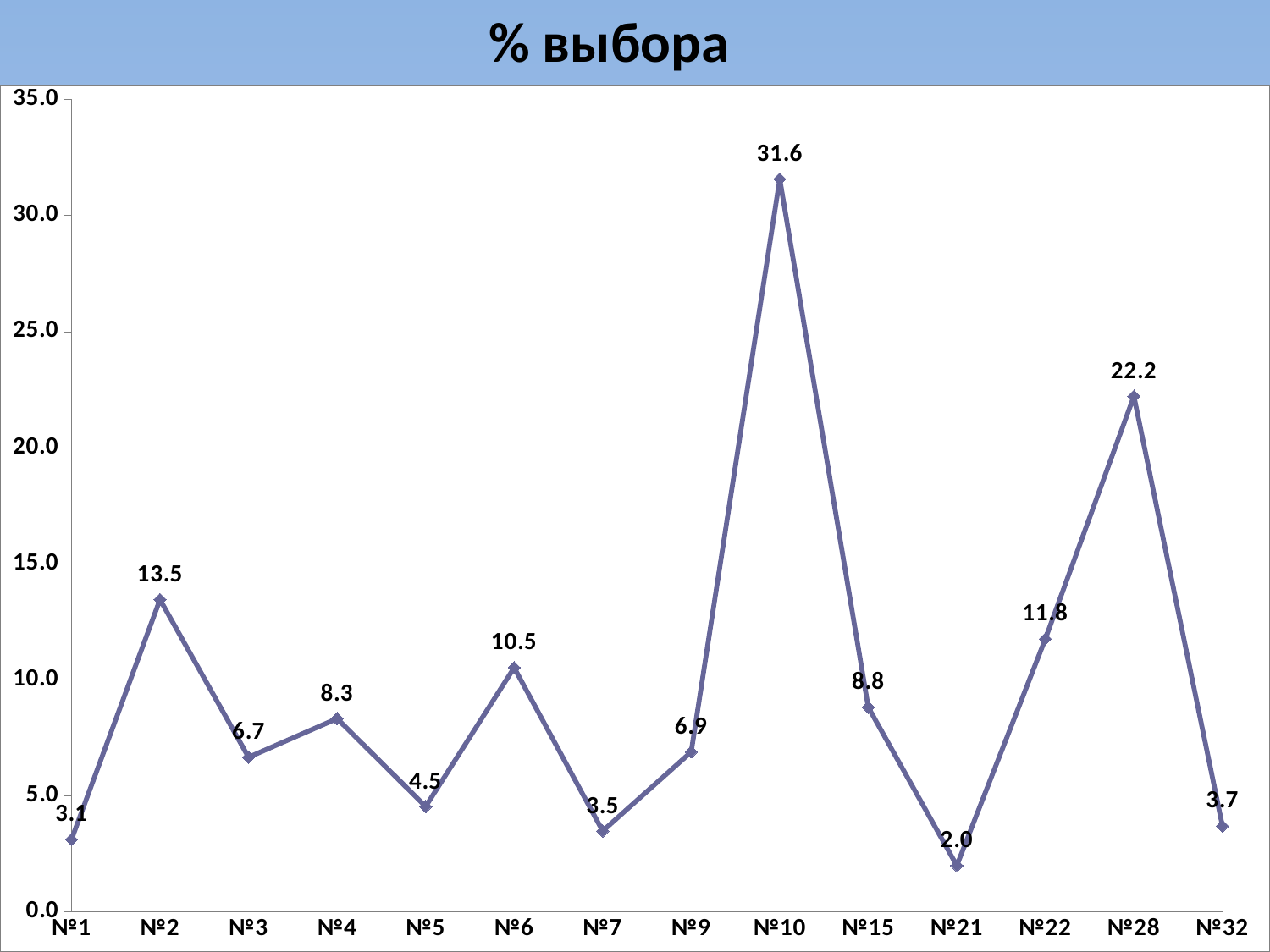
What is the value for №5? 4.5 Do the values rise or fall from №1 to №2? rise How many categories are plotted on the x axis? 14 What is the difference between the values for №10 and №28? 9.4 What kind of chart is shown? line chart What is the value for №28? 22.2 Is the value for №6 greater or less than 10.0? greater Which is larger, the value for №2 or the value for №22? №2 Which category has the lowest value? №21 Which category has the highest value? №10 What is the value for №10? 31.6 What is the title of the chart? % выбора